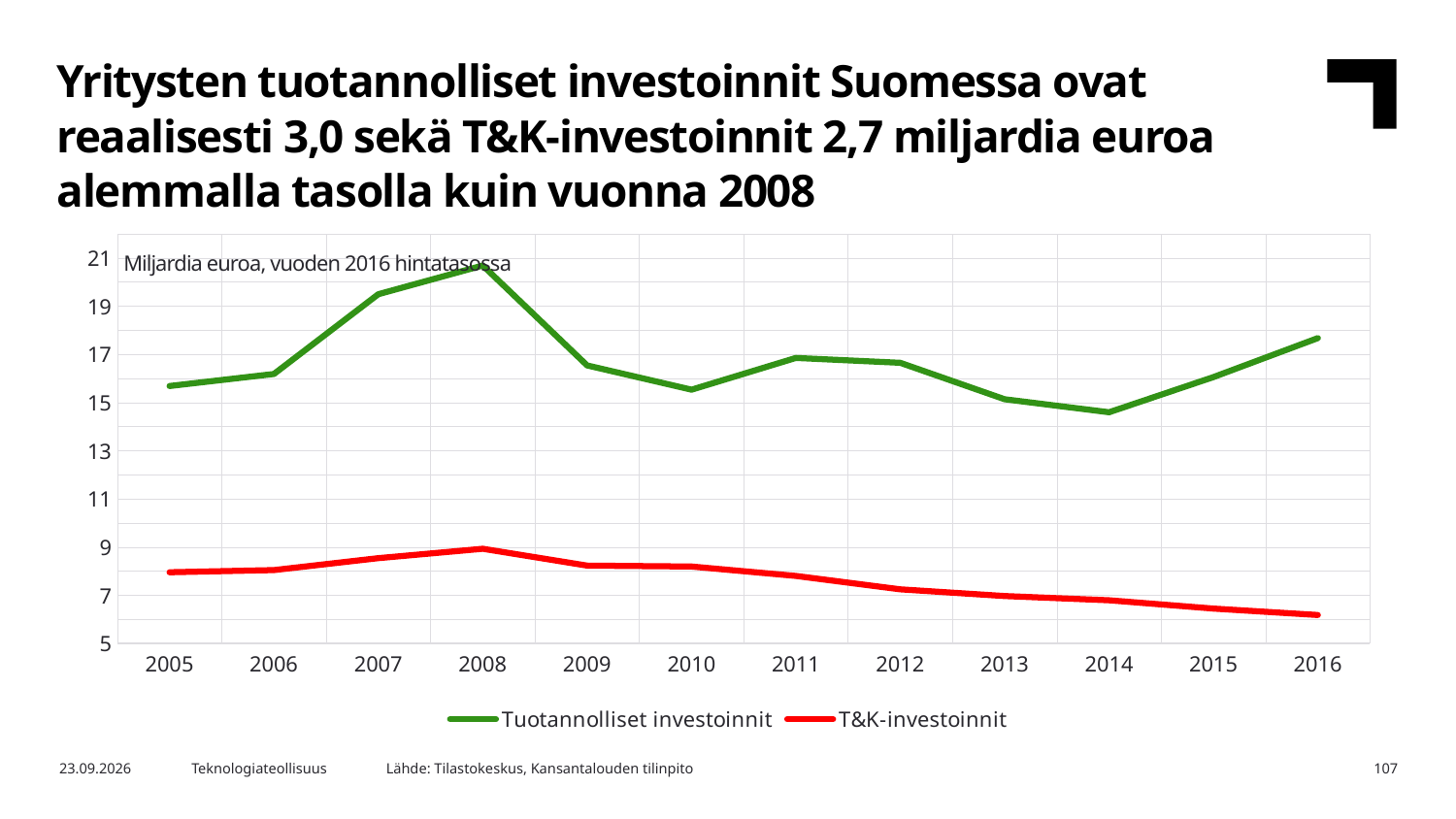
In which year is Tuotannolliset investoinnit at its highest? 2008 In which year is T&K-investoinnit at its highest? 2008 Is the value for T&K-investoinnit in 2016 greater or less than 7? less How many series does the legend list? 2 How many years are plotted along the x axis? 12 What unit label is shown inside the chart area? Miljardia euroa, vuoden 2016 hintatasossa Which series has the larger value in 2010, Tuotannolliset investoinnit or T&K-investoinnit? Tuotannolliset investoinnit Is the value for Tuotannolliset investoinnit in 2008 greater or less than 19? greater In which year is Tuotannolliset investoinnit at its lowest? 2014 What kind of chart is shown on the slide? line chart In which year is T&K-investoinnit at its lowest? 2016 Does T&K-investoinnit rise or fall from 2008 to 2016? fall